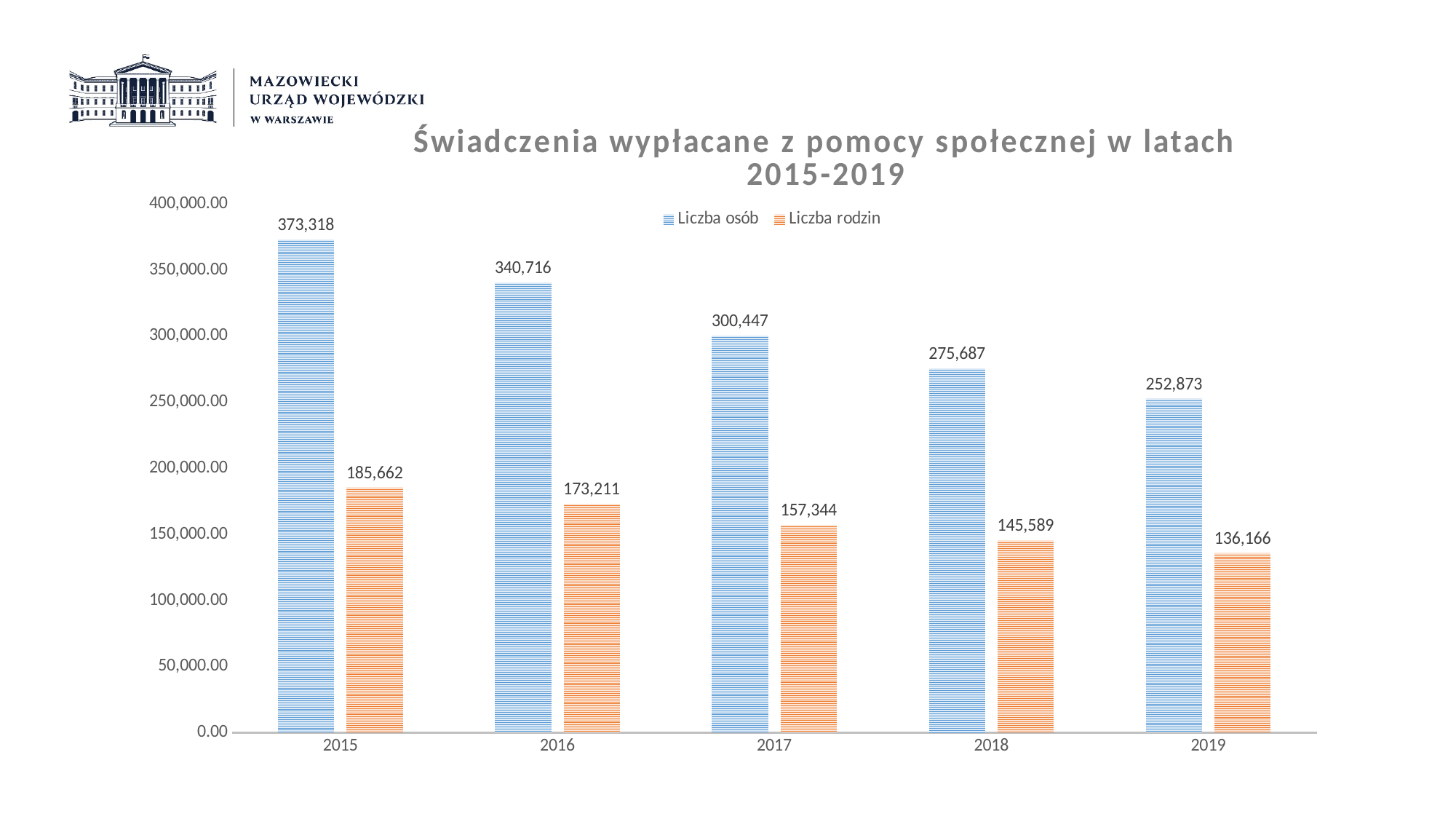
What is the difference between Liczba osób and Liczba rodzin in 2018? 130,098 What is the value of Liczba rodzin for 2019? 136,166 Which year has the highest value for Liczba osób? 2015 How many series does the legend list? 2 What is the value of Liczba rodzin for 2017? 157,344 Do the values of Liczba osób rise or fall from 2015 to 2019? fall What is the value of Liczba osób for 2015? 373,318 Is the value of Liczba rodzin for 2016 greater or less than 150,000.00? greater How many years are shown on the x axis? 5 Which is larger: Liczba osób in 2016 or Liczba osób in 2017? Liczba osób in 2016 Which year has the lowest value for Liczba rodzin? 2019 What kind of chart is shown on the slide? bar chart